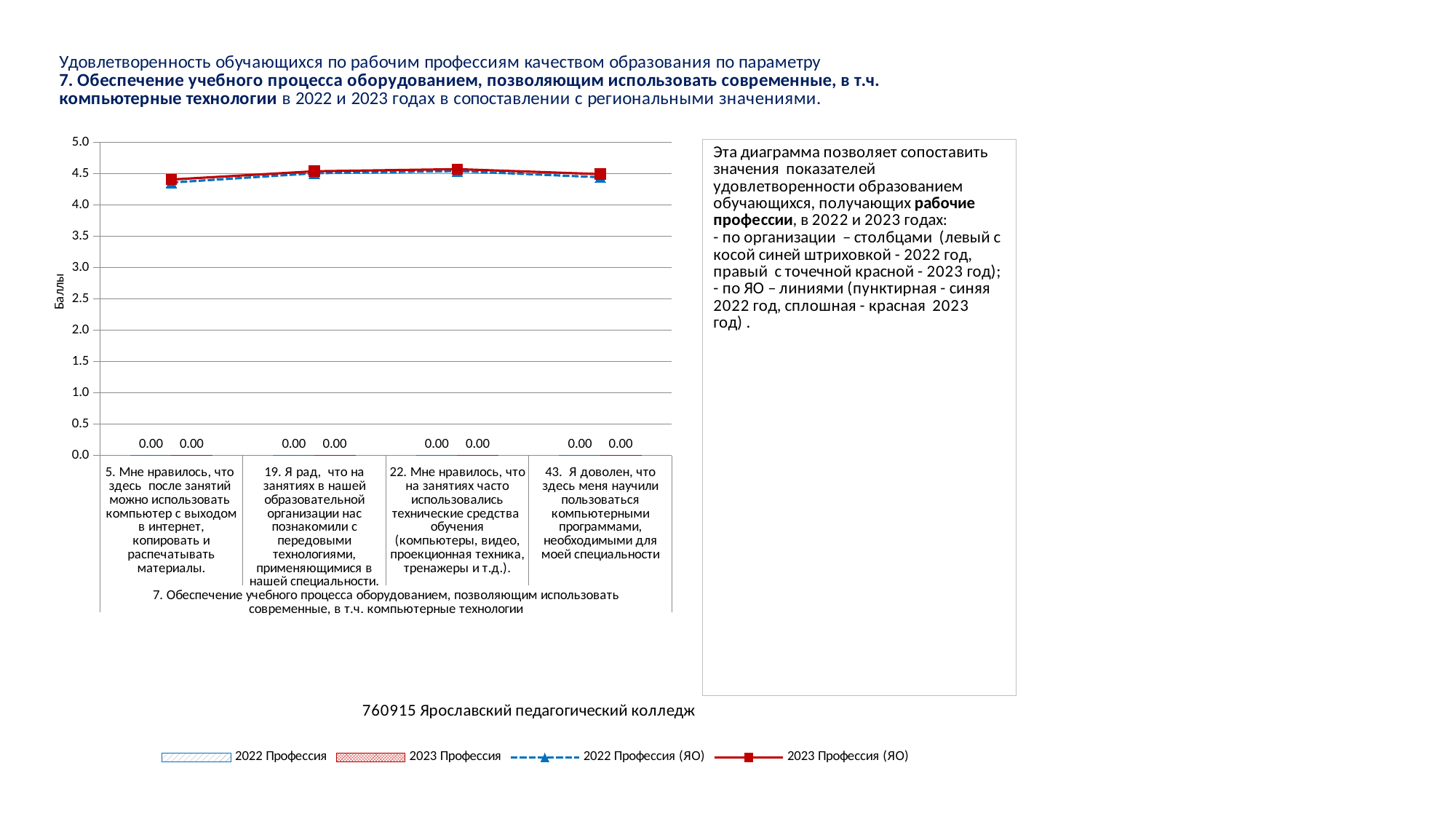
How many series does the chart legend list? 4 How many categories (questions) are shown along the x axis of the chart? 4 What is the value of the 2022 Профессия bar for category 5 ("Мне нравилось, что здесь после занятий можно использовать компьютер...")? 0.00 For category 5, which line is higher: 2022 Профессия (ЯО) or 2023 Профессия (ЯО)? 2023 Профессия (ЯО) Is the value of the 2023 Профессия (ЯО) line for category 19 greater or less than 4.0? greater Is the value of the 2022 Профессия (ЯО) line for category 43 greater or less than 4.0? greater What is the highest tick value shown on the vertical axis? 5.0 What kind of chart is shown on the slide? A combined bar and line chart Is the value of the 2023 Профессия (ЯО) line for category 22 greater or less than 5.0? less What is the value of the 2023 Профессия bar for category 43 ("Я доволен, что здесь меня научили пользоваться компьютерными программами...")? 0.00 What is the title of the vertical axis of the chart? Баллы